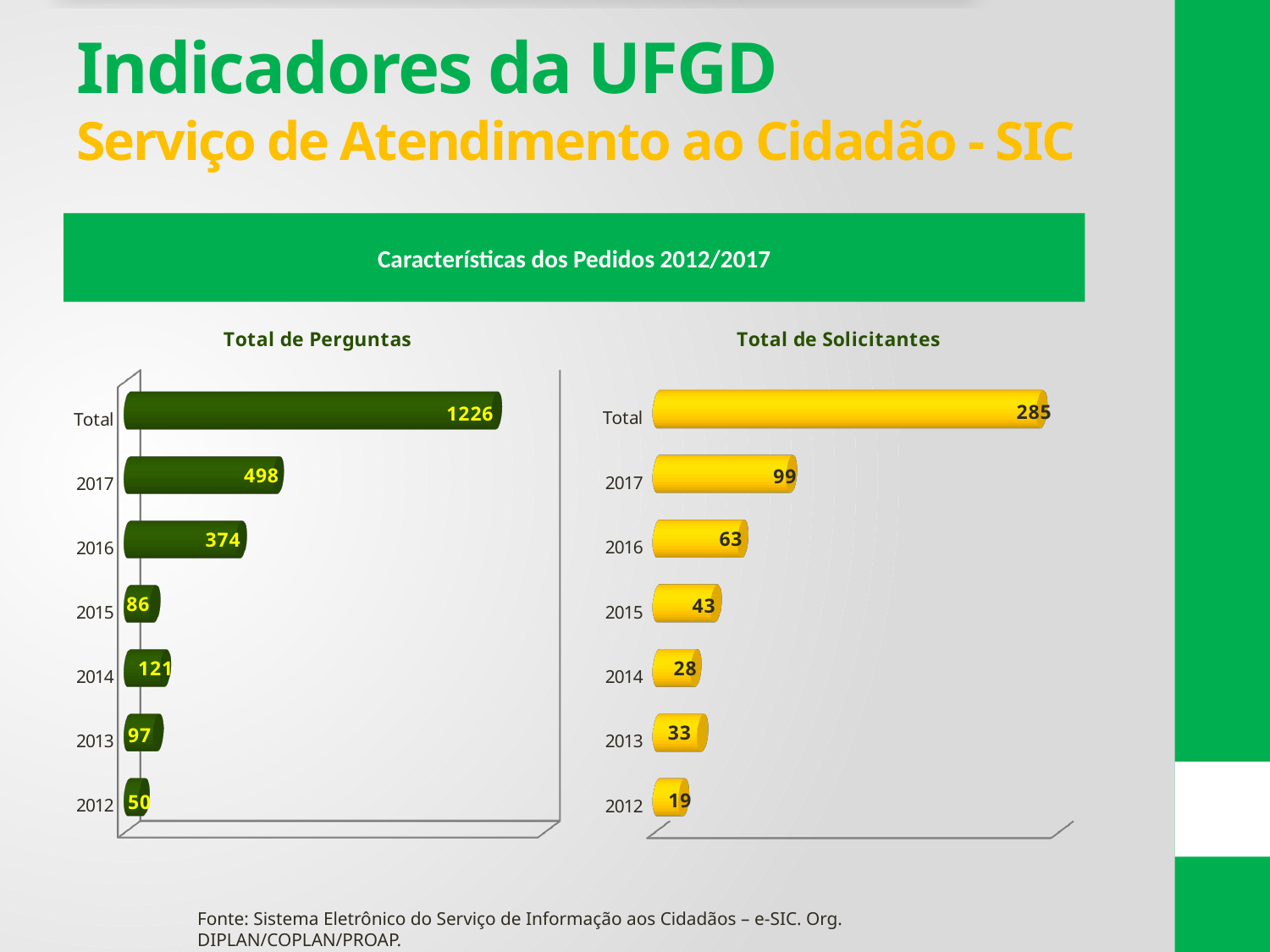
In the 'Total de Perguntas' chart, which is larger, the value for 2014 or the value for 2013? 2014 What is the title of the chart on the right side of the slide? Total de Solicitantes In the 'Total de Solicitantes' chart, which year has the lowest value? 2012 In the 'Total de Perguntas' chart, which year (excluding the Total bar) has the highest value? 2017 How many bars are shown in the 'Total de Solicitantes' chart? 7 In the 'Total de Perguntas' chart, what is the value for 2017? 498 What kind of chart is 'Total de Perguntas'? Bar chart In the 'Total de Perguntas' chart, what is the difference between the values for 2017 and 2016? 124 In the 'Total de Solicitantes' chart, which is larger, the value for 2013 or the value for 2014? 2013 In the 'Total de Solicitantes' chart, what is the value for 2015? 43 In the 'Total de Solicitantes' chart, what is the difference between the values for 2017 and 2012? 80 In the 'Total de Perguntas' chart, what is the value labelled 'Total'? 1226